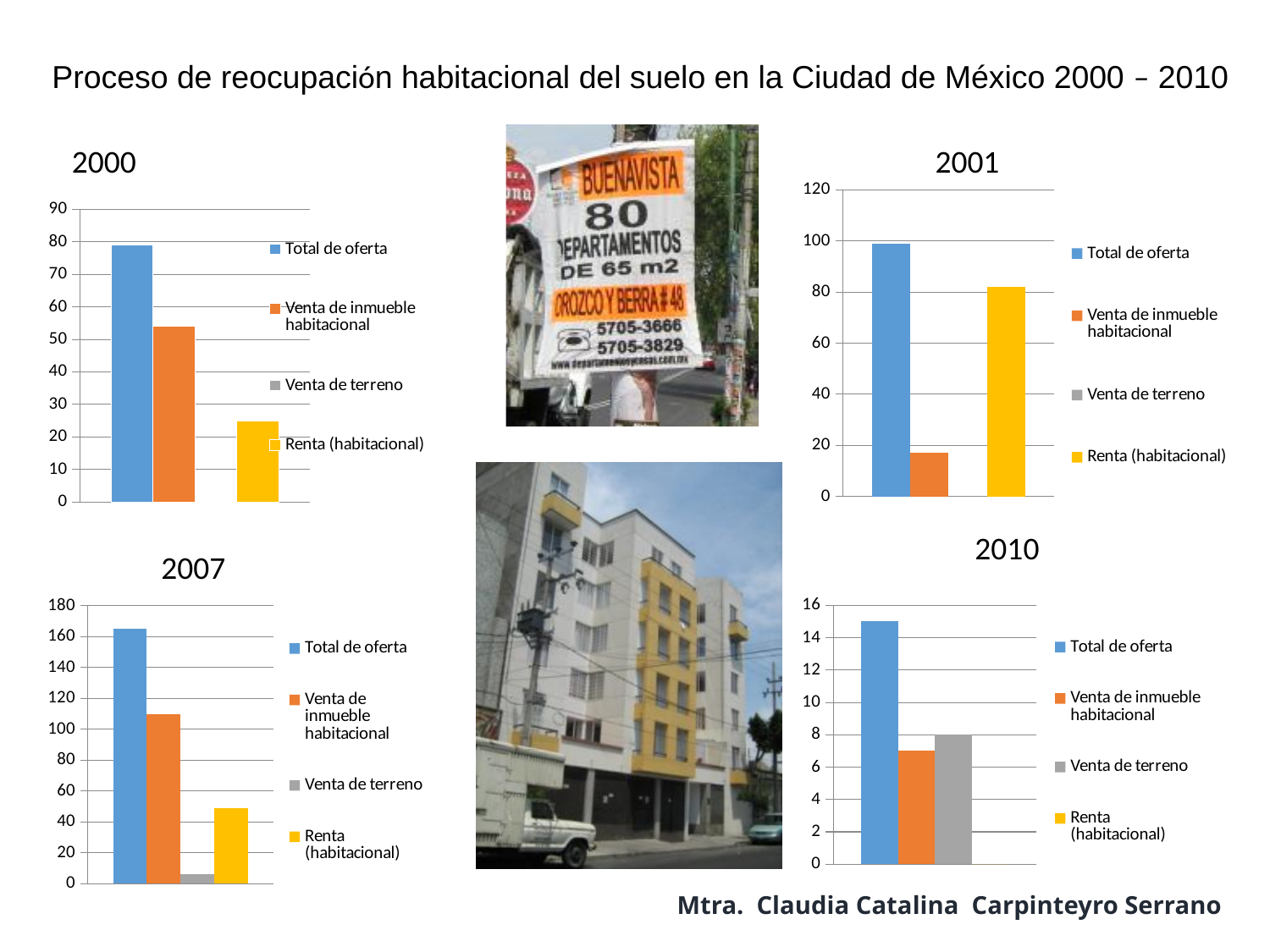
In the chart titled 2010, what is the value for Venta de terreno? 8 In the chart titled 2000, which series has the highest value? Total de oferta In the chart titled 2001, is the value for Venta de inmueble habitacional greater or less than 20? less How many bar charts are shown on the slide? 4 In the chart titled 2000, is the value for Total de oferta greater or less than 70? greater In the chart titled 2010, is the value for Total de oferta greater or less than 14? greater How many series does the legend of the chart titled 2001 list? 4 What is the title of the chart in the bottom-right of the slide? 2010 In the chart titled 2007, which of the visible bars is the lowest? Venta de terreno In the chart titled 2001, which is larger: Venta de inmueble habitacional or Renta (habitacional)? Renta (habitacional) What kind of chart is the chart titled 2000? bar chart